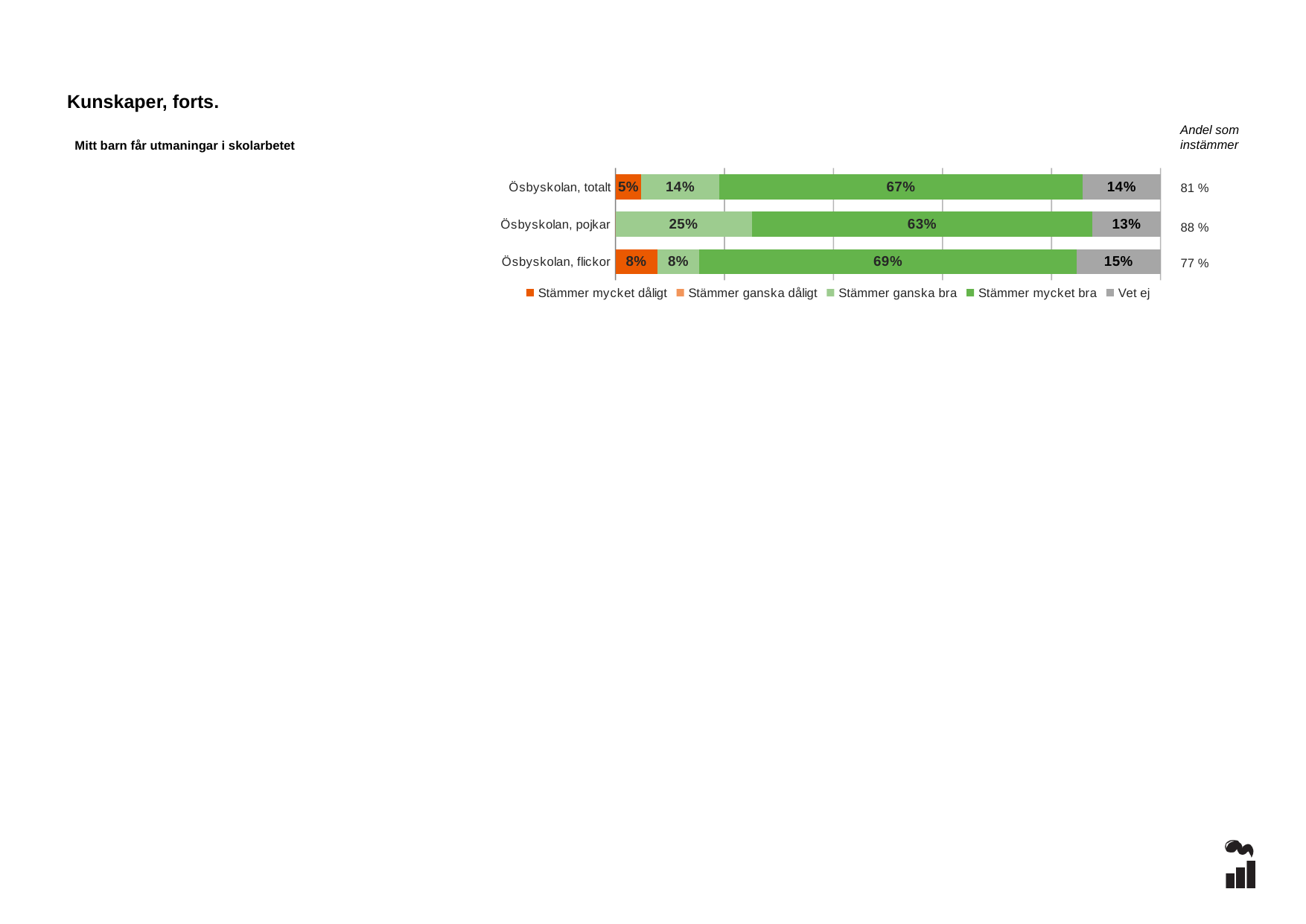
What is the value for "Stämmer mycket dåligt" for Ösbyskolan, flickor? 8% What is the value for "Stämmer mycket bra" for Ösbyskolan, totalt? 67% What kind of chart is shown on the slide? Stacked bar chart How many categories are shown on the chart? 3 How many series does the legend list? 5 What is the difference between the "Stämmer mycket bra" values for Ösbyskolan, flickor and Ösbyskolan, pojkar? 6% Which category has the highest value for "Stämmer mycket bra"? Ösbyskolan, flickor Which category has the lowest "Andel som instämmer" figure? Ösbyskolan, flickor What is the value for "Stämmer ganska bra" for Ösbyskolan, pojkar? 25% What is the "Andel som instämmer" figure shown for Ösbyskolan, pojkar? 88 % What is the value for "Vet ej" for Ösbyskolan, flickor? 15% Which is larger: the "Stämmer ganska bra" value for Ösbyskolan, totalt or for Ösbyskolan, pojkar? Ösbyskolan, pojkar